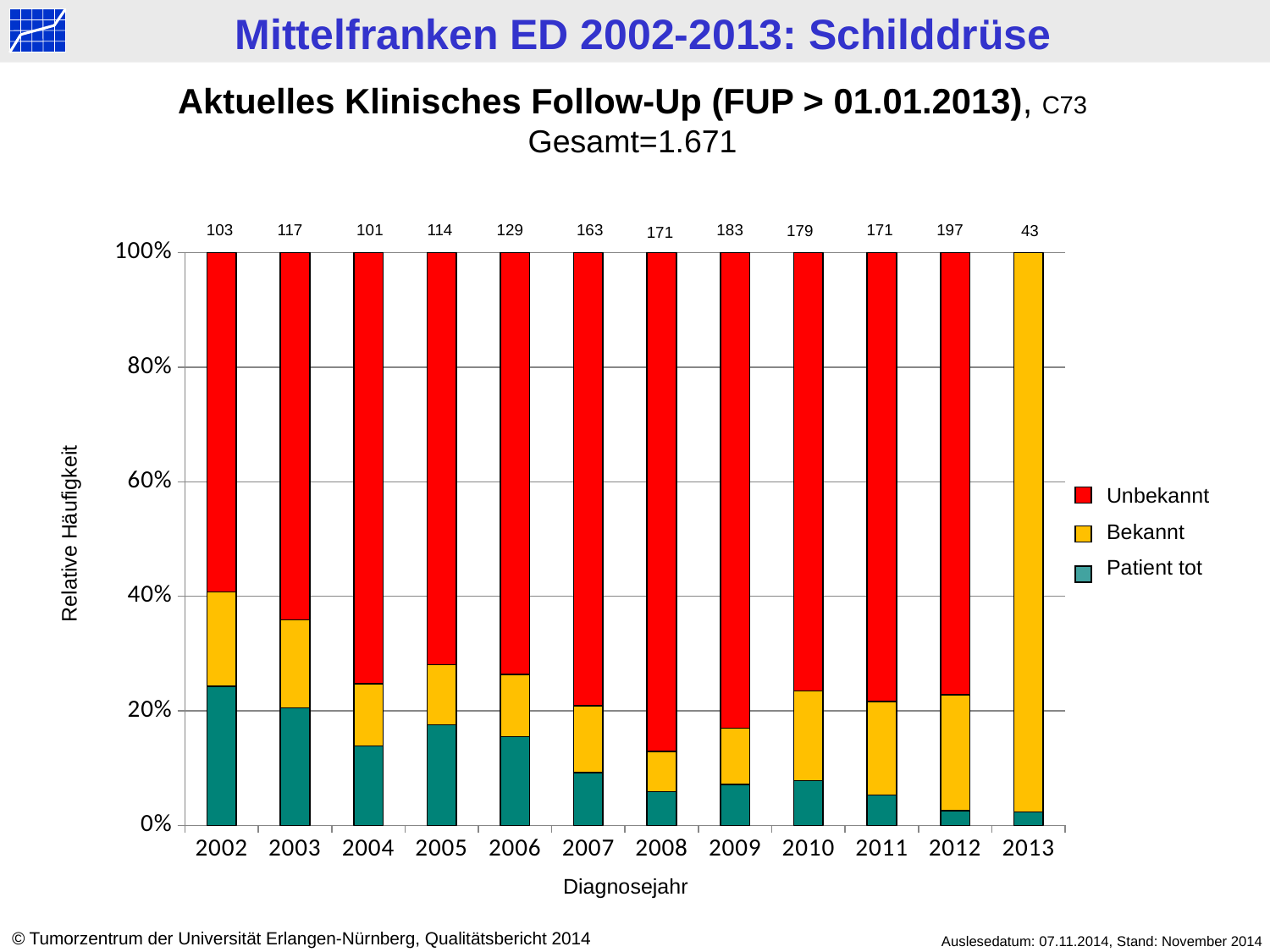
What number is printed above the bar for 2002? 103 What number is printed above the bar for 2012? 197 How many series does the legend list? 3 What number is printed above the bar for 2013? 43 Is the share of 'Bekannt' in 2013 greater or less than 80%? greater What is the difference between the numbers printed above the bars for 2012 and 2013? 154 Which year has the larger number printed above its bar, 2009 or 2010? 2009 How many diagnosis years are shown on the x axis? 12 Which diagnosis year has the lowest number printed above its bar? 2013 Which diagnosis year has the highest number printed above its bar? 2012 What kind of chart is shown on the slide? Stacked bar chart Is the share of 'Patient tot' in 2002 greater or less than 20%? greater